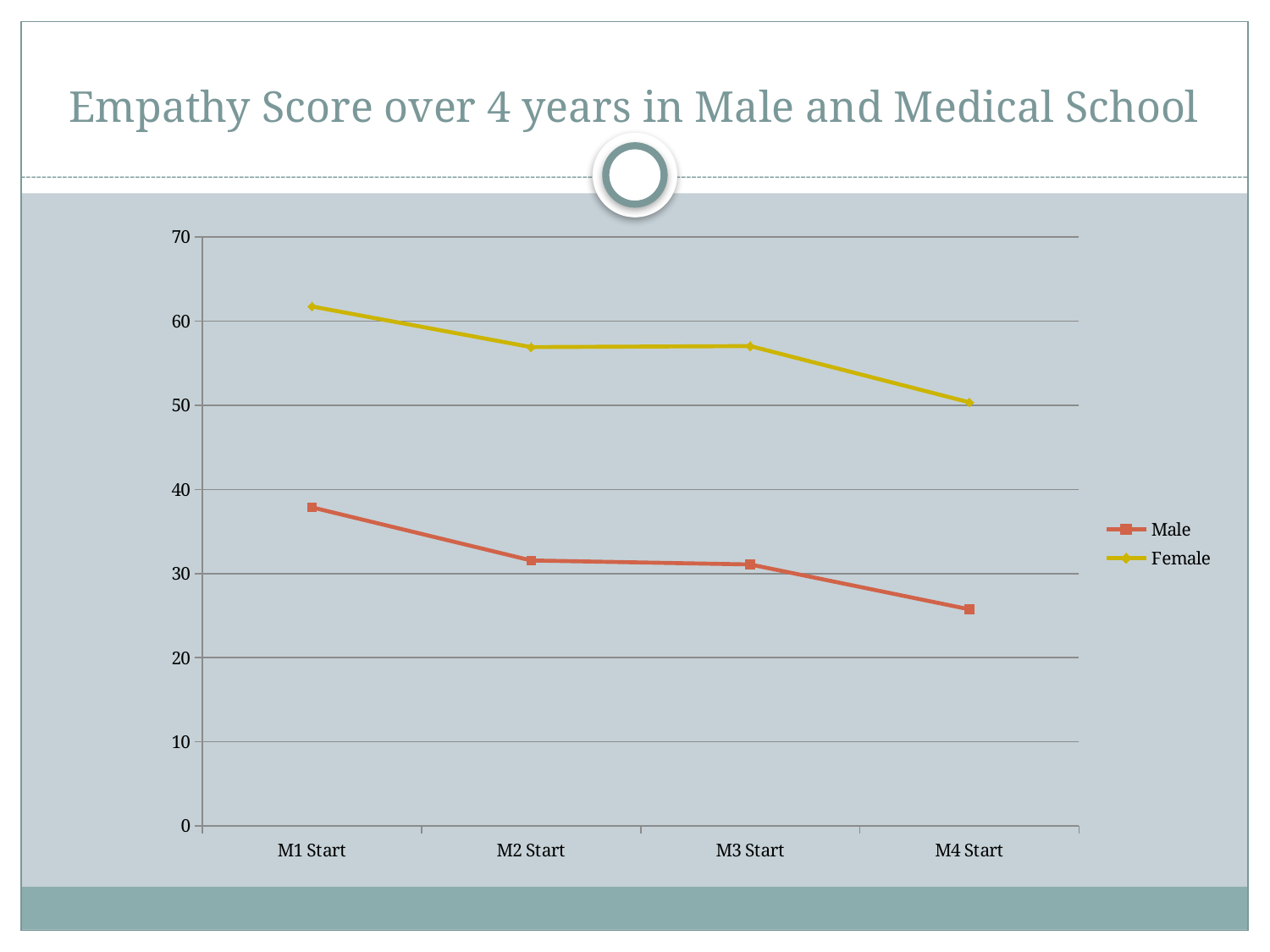
Is the value for Male at M1 Start greater or less than 40? less At which point is the Female series highest? M1 Start At which point is the Male series lowest? M4 Start What kind of chart is shown on the slide? line chart Is the value for Female at M4 Start greater or less than 40? greater How many series does the legend list? 2 Does the Male series rise or fall from M1 Start to M4 Start? fall At which point is the Female series lowest? M4 Start How many points are plotted along the x axis for each series? 4 Which series is plotted in yellow? Female Is the value for Male at M4 Start greater or less than 20? greater At M1 Start, which series has the larger value, Male or Female? Female